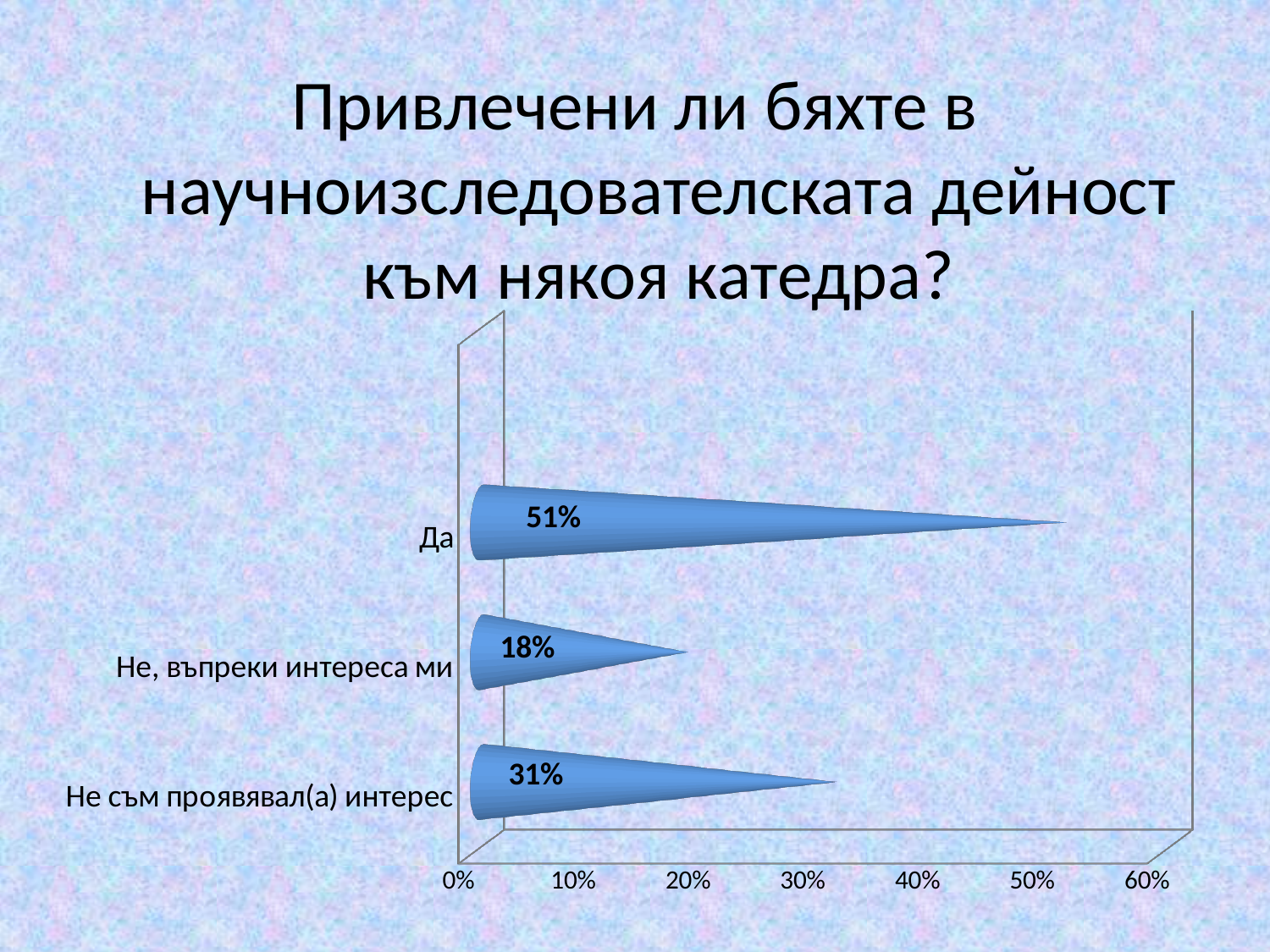
Is the value for "Да" greater or less than 40%? greater What is the title of the chart on the slide? Привлечени ли бяхте в научноизследователската дейност към някоя катедра? What is the value for "Да"? 51% Which category has the highest value? Да What kind of chart is shown on the slide? bar chart What is the value for "Не, въпреки интереса ми"? 18% Which category has the lowest value? Не, въпреки интереса ми What is the difference between the values for "Да" and "Не съм проявявал(а) интерес"? 20% What is the difference between the values for "Не съм проявявал(а) интерес" and "Не, въпреки интереса ми"? 13% What is the value for "Не съм проявявал(а) интерес"? 31% Which is larger, the value for "Не, въпреки интереса ми" or the value for "Не съм проявявал(а) интерес"? Не съм проявявал(а) интерес How many categories are shown in the chart? 3